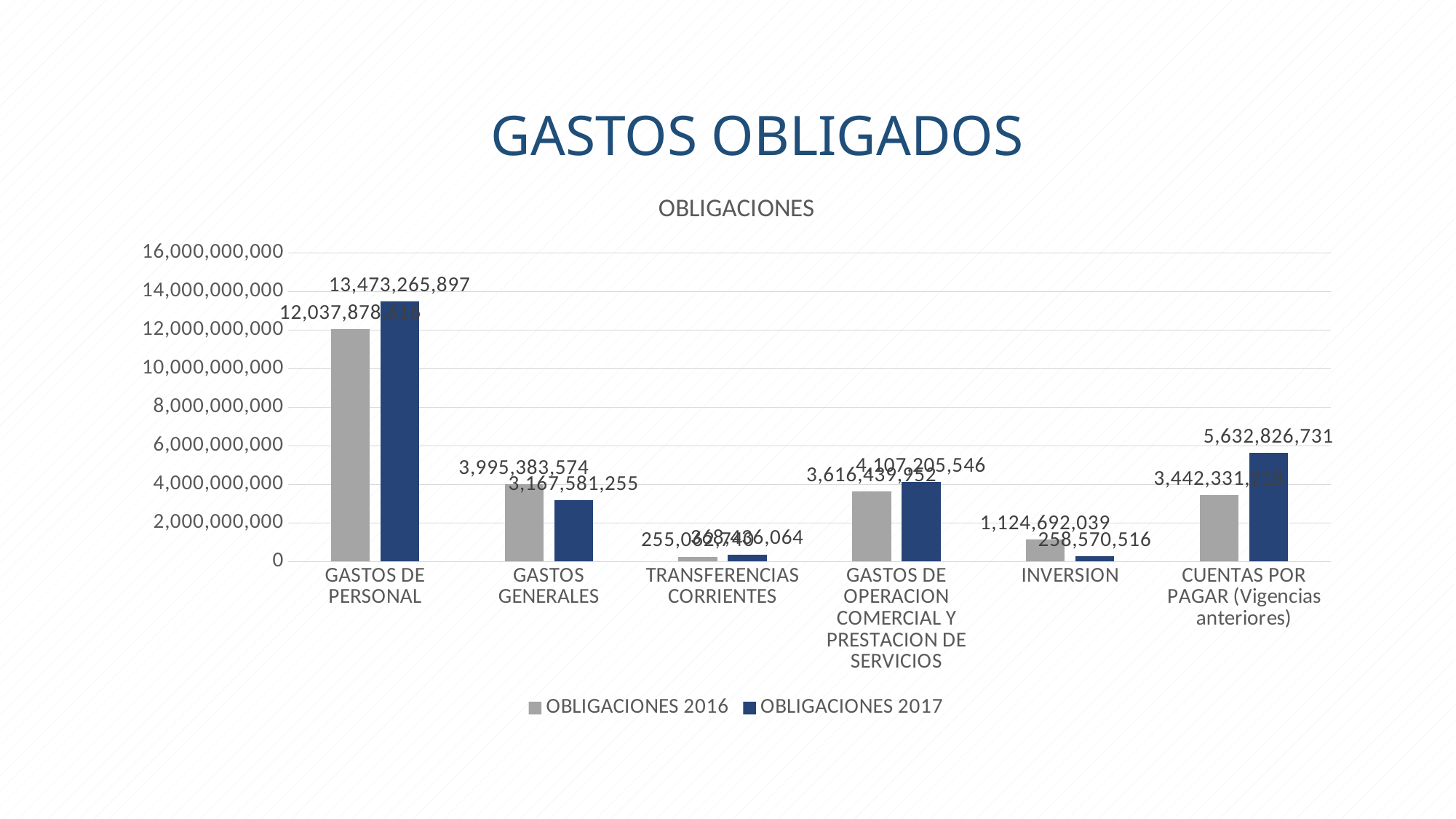
What is the value of OBLIGACIONES 2017 for CUENTAS POR PAGAR (Vigencias anteriores)? 5,632,826,731 What is the difference between OBLIGACIONES 2016 and OBLIGACIONES 2017 for INVERSION? 866,121,523 How many series does the legend list? 2 Which category has the highest OBLIGACIONES 2017 value? GASTOS DE PERSONAL What is the value of OBLIGACIONES 2016 for GASTOS GENERALES? 3,995,383,574 For GASTOS GENERALES, which is larger: OBLIGACIONES 2016 or OBLIGACIONES 2017? OBLIGACIONES 2016 What is the value of OBLIGACIONES 2017 for INVERSION? 258,570,516 Is the OBLIGACIONES 2016 value for GASTOS DE PERSONAL greater or less than 10,000,000,000? greater How many categories are shown on the x axis of the chart? 6 What is the value of OBLIGACIONES 2017 for GASTOS DE PERSONAL? 13,473,265,897 What is the value of OBLIGACIONES 2017 for GASTOS DE OPERACION COMERCIAL Y PRESTACION DE SERVICIOS? 4,107,205,546 What is the difference between OBLIGACIONES 2016 and OBLIGACIONES 2017 for GASTOS GENERALES? 827,802,319